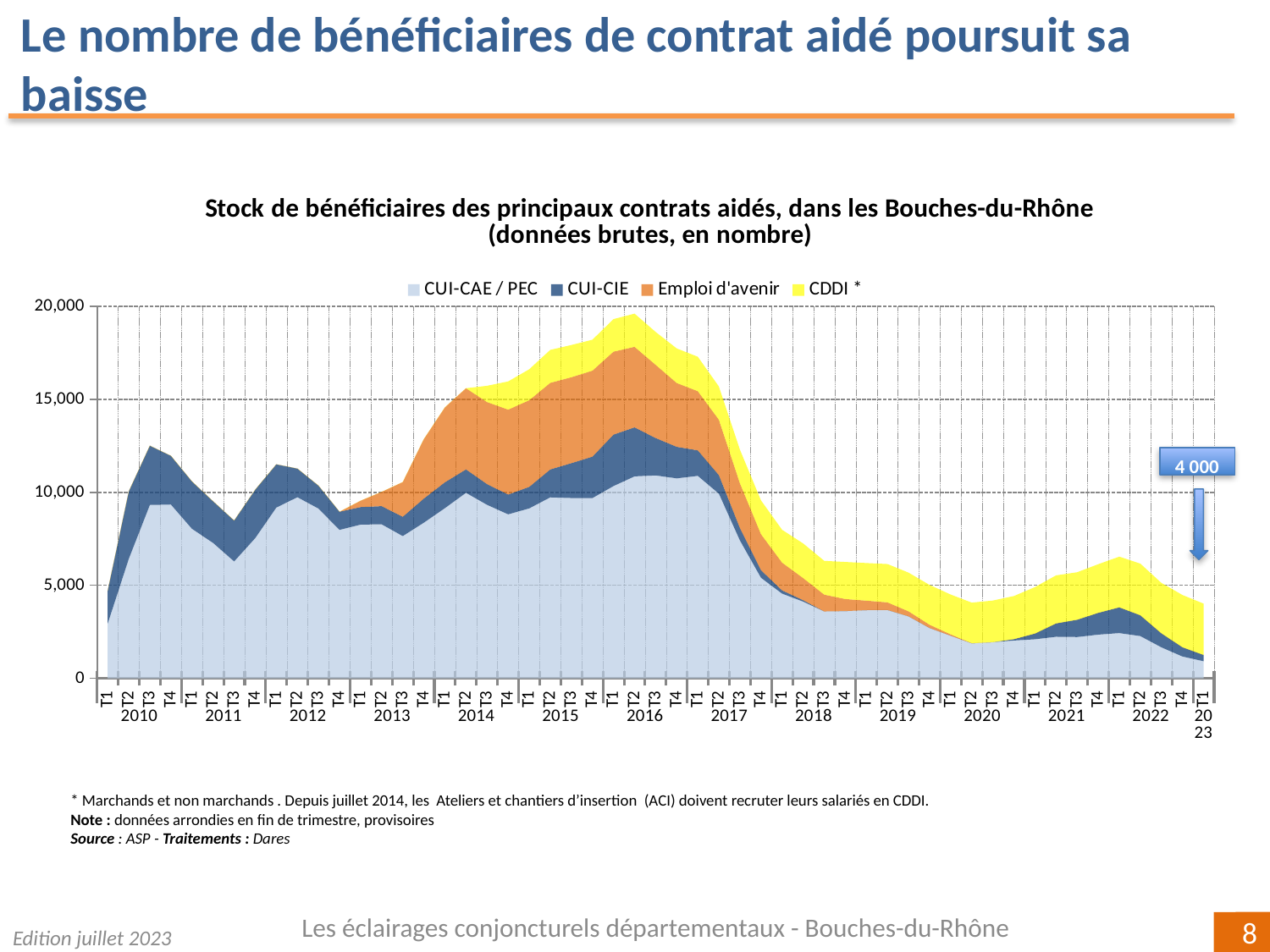
Is the total stock of beneficiaries at T1 2018 greater or less than 10,000? less Which series is shown in yellow? CDDI * Is the total stock of beneficiaries at T1 2010 greater or less than 5,000? less How many years are labelled on the x axis? 14 Does the total stock of beneficiaries rise or fall between 2017 and 2018? Fall Is the total stock of beneficiaries at T2 2016 greater or less than 15,000? greater Is the total stock of beneficiaries larger at T2 2016 or at T1 2023? T2 2016 In which year does the total stock of beneficiaries reach its highest level? 2016 What value does the callout label show for the last point (T1 2023)? 4 000 How many series does the legend list? 4 What kind of chart is shown on the slide? Stacked area chart